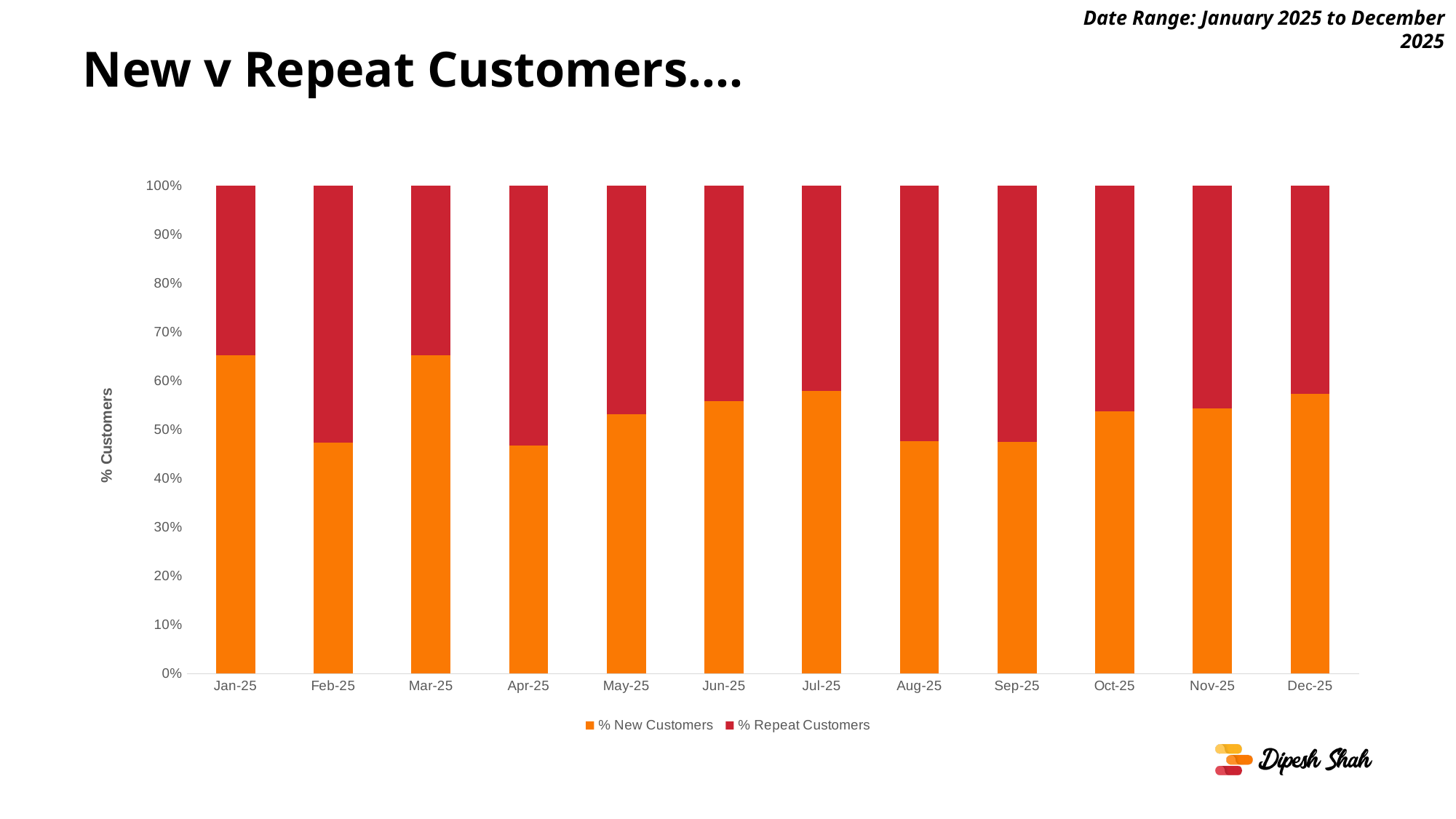
Is the value for % New Customers in Jan-25 greater or less than 60%? greater What kind of chart is shown on the slide? Stacked bar chart Is the value for % New Customers in Jul-25 greater or less than 50%? greater What is the total of the stacked bar for Dec-25? 100% Which series is shown in orange in the chart? % New Customers How many series does the chart legend list? 2 How many months are shown on the x axis of the chart? 12 Is the value for % New Customers in Apr-25 greater or less than 50%? less Which month has the larger share of % Repeat Customers, Feb-25 or Mar-25? Feb-25 What label is shown on the y axis of the chart? % Customers Which month has the larger share of % New Customers, Jan-25 or Feb-25? Jan-25